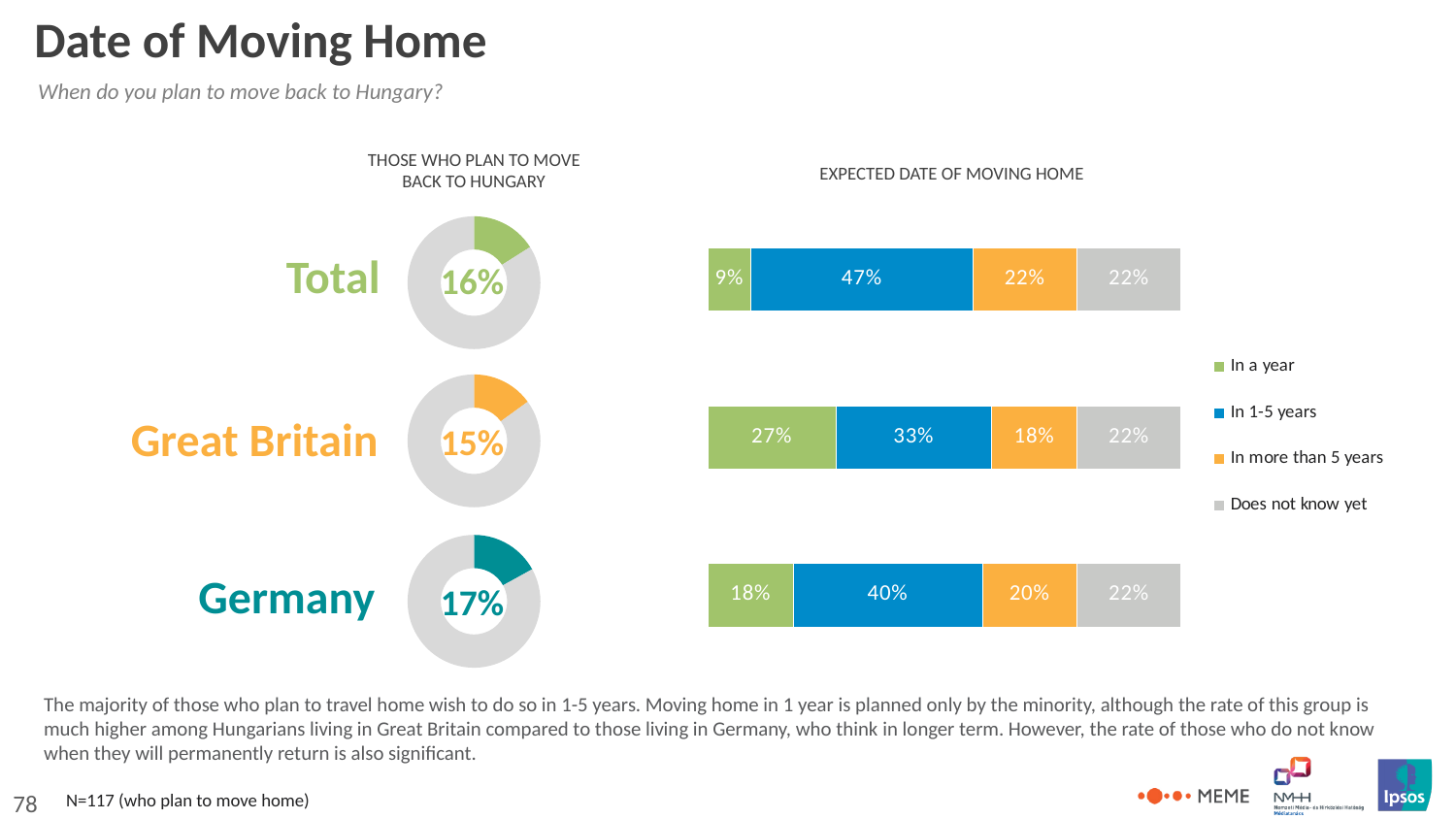
In the 'Expected date of moving home' bar chart, what is the value for 'Does not know yet' in the Great Britain bar? 22% In the 'Expected date of moving home' bar chart, which group has the highest value for 'In a year'? Great Britain In the 'Expected date of moving home' bar chart, what is the value for 'In a year' in the Great Britain bar? 27% In the 'Expected date of moving home' bar chart, what is the value for 'In 1-5 years' in the Total bar? 47% In the 'Expected date of moving home' bar chart, what is the difference between the 'In 1-5 years' values for Total and Great Britain? 14% How many series does the legend of the 'Expected date of moving home' bar chart list? 4 In the 'Those who plan to move back to Hungary' donut charts, what share of the Germany group plans to move back to Hungary? 17% In the 'Those who plan to move back to Hungary' donut charts, what share of the Total group plans to move back to Hungary? 16% What kind of chart is the 'Expected date of moving home' chart? Stacked bar chart In the 'Those who plan to move back to Hungary' donut charts, which group has the lowest share planning to move back? Great Britain In the 'Expected date of moving home' bar chart, what is the value for 'In more than 5 years' in the Germany bar? 20% In the 'Expected date of moving home' bar chart, which is larger: 'In a year' for Germany or 'In a year' for Total? Germany